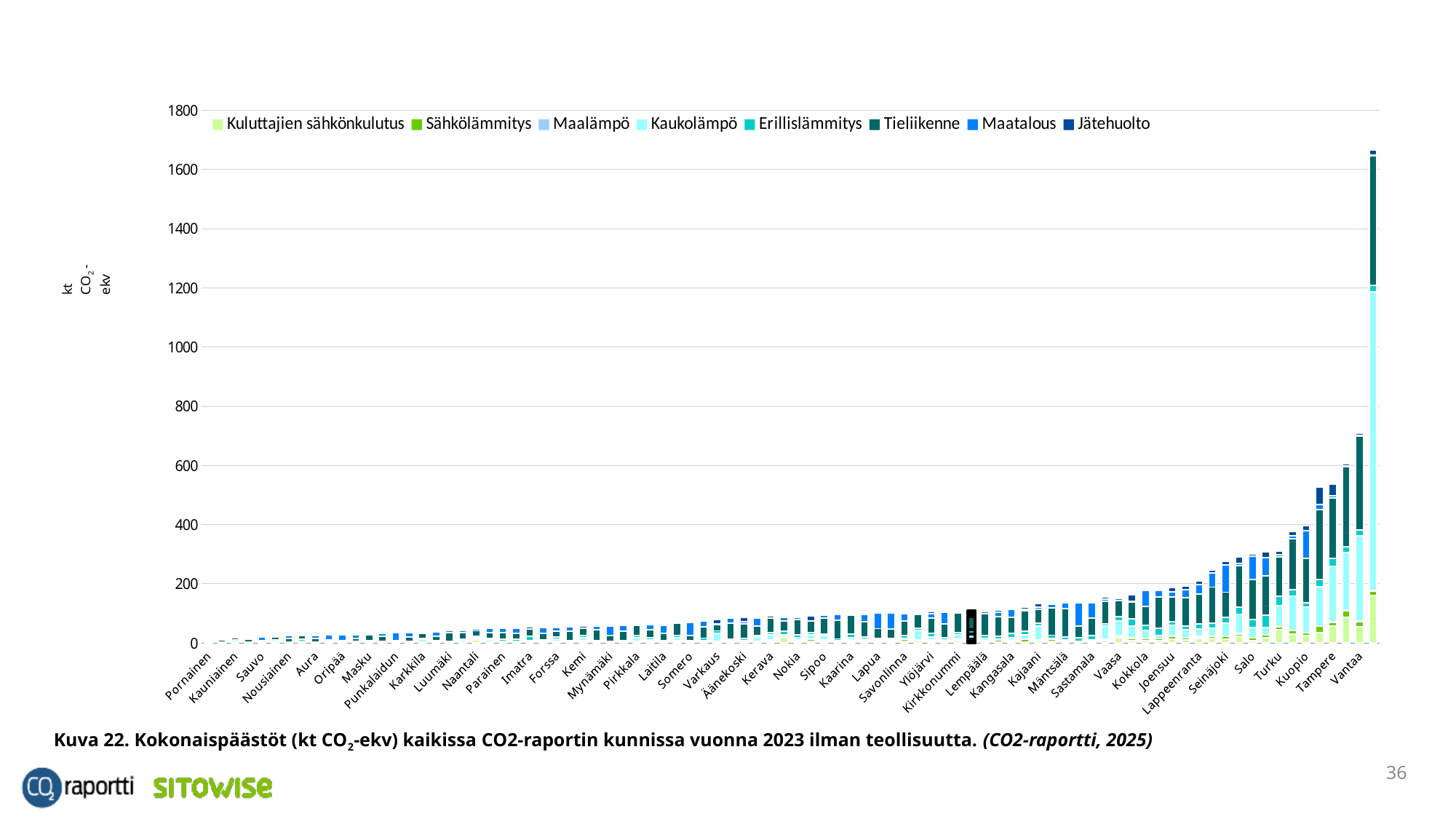
Which has the larger total, Kuopio or Turku? Kuopio Is the total value for Vaasa greater or less than 200? less Is the total value for Tampere greater or less than 600? less Which has the larger total, Vantaa or Tampere? Vantaa What kind of chart is shown on the slide? stacked bar chart Which series is listed first in the legend? Kuluttajien sähkönkulutus How many series does the legend list? 8 Is the total value for Turku greater or less than 400? less Do the bar totals rise or fall from left to right along the x axis? rise